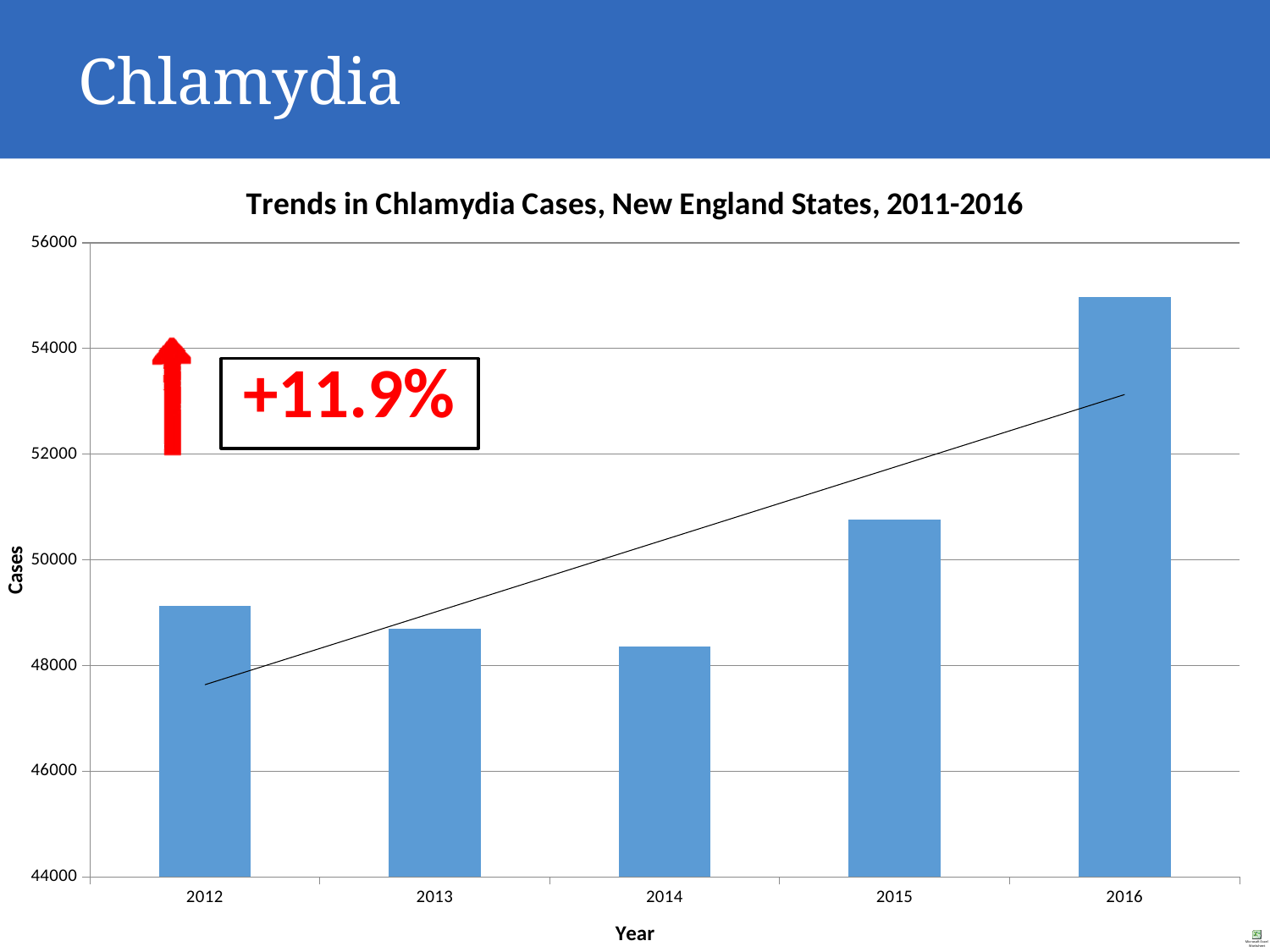
Which year has the lowest number of cases? 2014 Is the value for 2015 greater or less than 50000? greater Which year has more cases, 2015 or 2016? 2016 What percentage change is shown in the annotation box on the chart? +11.9% What kind of chart is shown on the slide? Bar chart Which year has more cases, 2012 or 2013? 2012 Which year has the highest number of cases? 2016 Is the value for 2016 greater or less than 54000? greater Is the value for 2014 greater or less than 50000? less How many years are plotted on the x axis of the chart? 5 What is the title of the chart? Trends in Chlamydia Cases, New England States, 2011-2016 Do the values rise or fall from 2014 to 2016? Rise